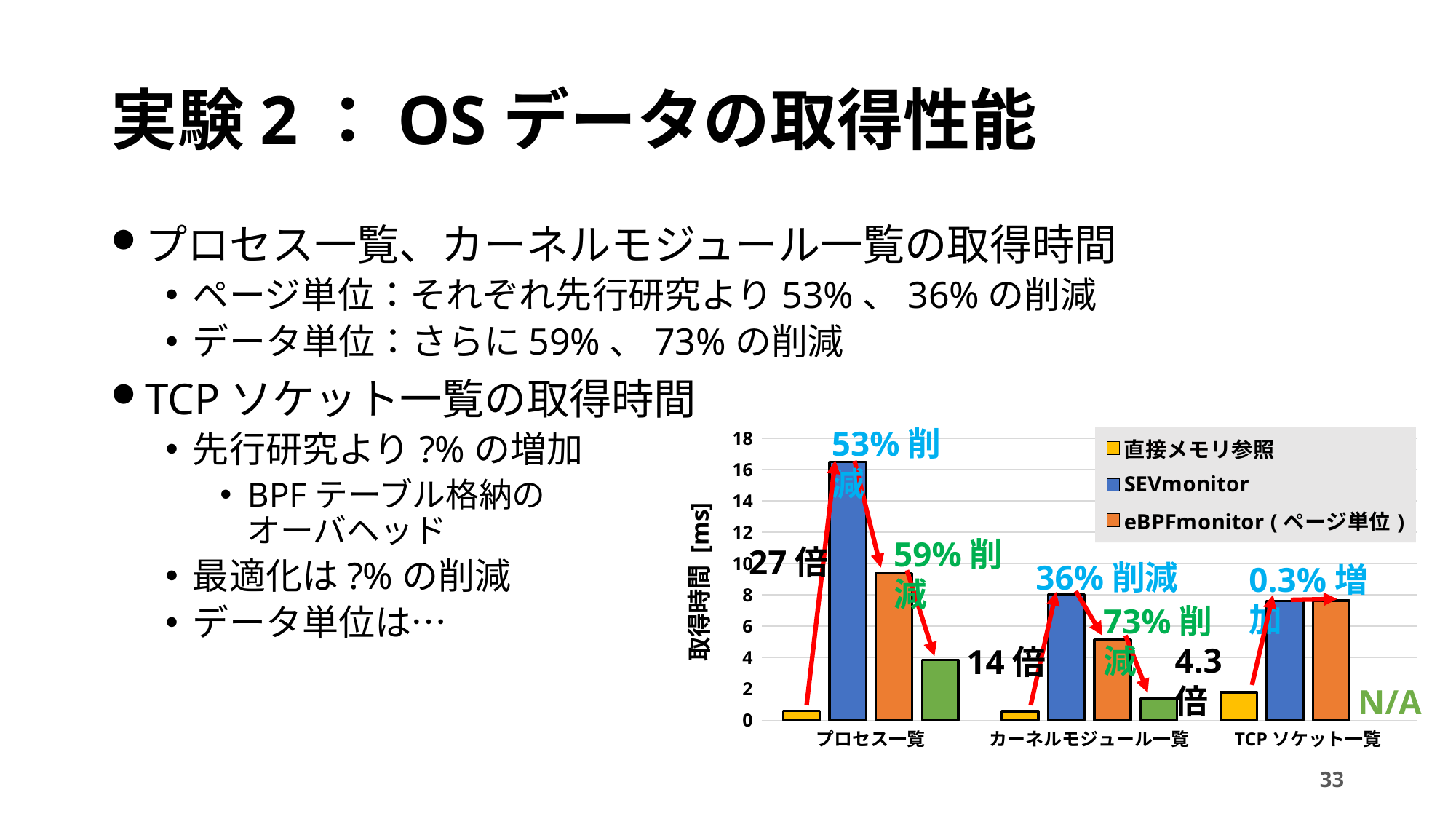
Is the eBPFmonitor (ページ単位) value for プロセス一覧 greater or less than 8? greater Do the SEVmonitor values rise or fall from プロセス一覧 to TCP ソケット一覧? fall Is the 直接メモリ参照 value for TCP ソケット一覧 greater or less than 4? less Is the SEVmonitor value for プロセス一覧 greater or less than 14? greater How many categories are shown on the x axis of the chart? 3 What kind of chart is shown on the slide? bar chart For プロセス一覧, which is larger: the SEVmonitor bar or the eBPFmonitor (ページ単位) bar? SEVmonitor What is the label of the chart's y axis? 取得時間 [ms] Which category has the highest SEVmonitor bar? プロセス一覧 In the TCP ソケット一覧 category, which series has the lowest bar? 直接メモリ参照 How many series does the chart's legend list? 3